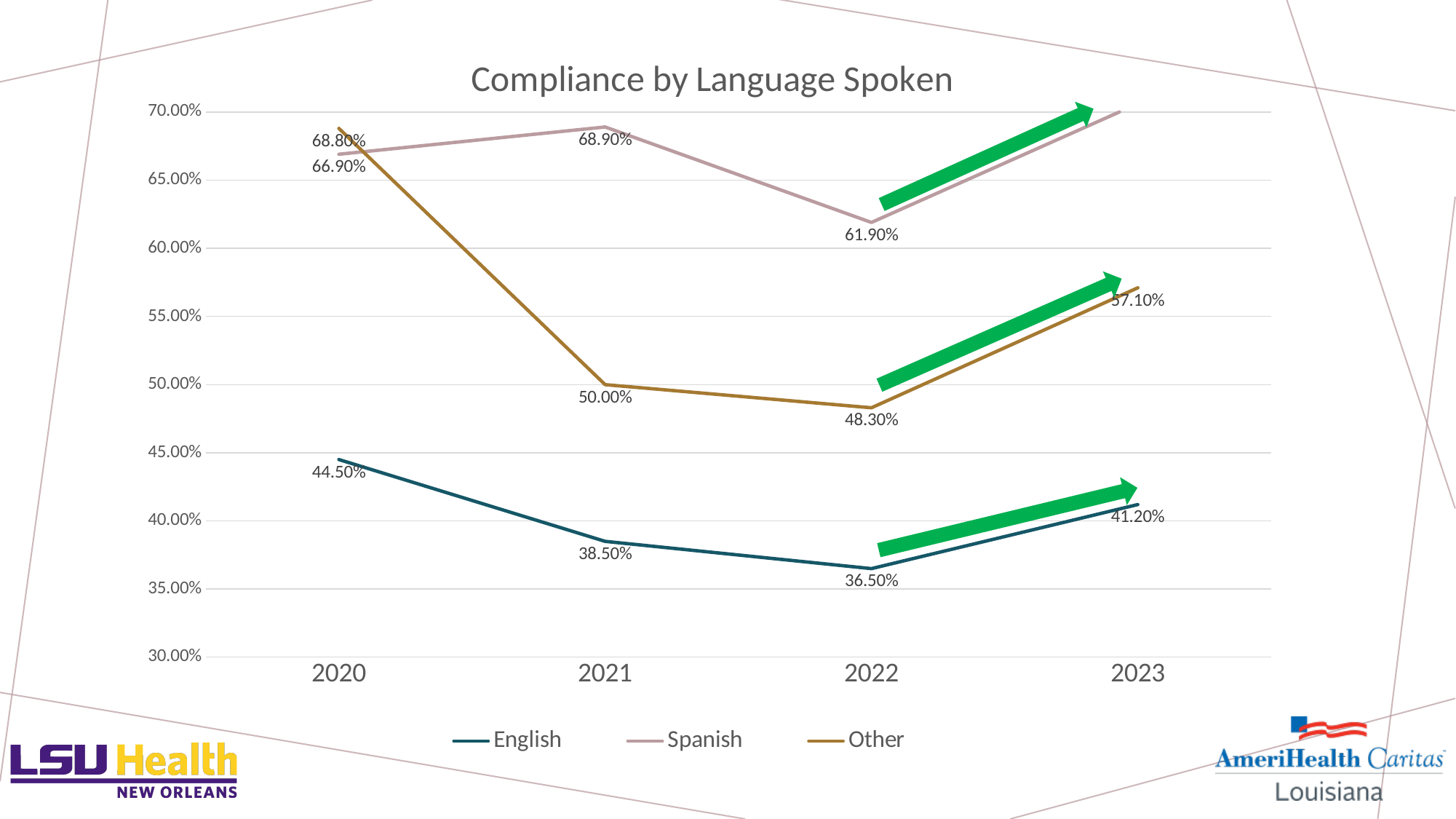
What is the compliance value for Other in 2021? 50.00% Does the English line rise or fall from 2020 to 2022? fall In which year is the English value lowest? 2022 In 2020, which is higher: Other or Spanish? Other What kind of chart is shown on the slide? line chart What is the compliance value for English in 2022? 36.50% By how much did the English value increase from 2022 to 2023? 4.70% Is the value for Spanish in 2023 greater or less than 65.00%? greater In which year is the Other value highest? 2020 What is the compliance value for Spanish in 2021? 68.90% How many series does the legend list? 3 How many years are shown on the x axis? 4